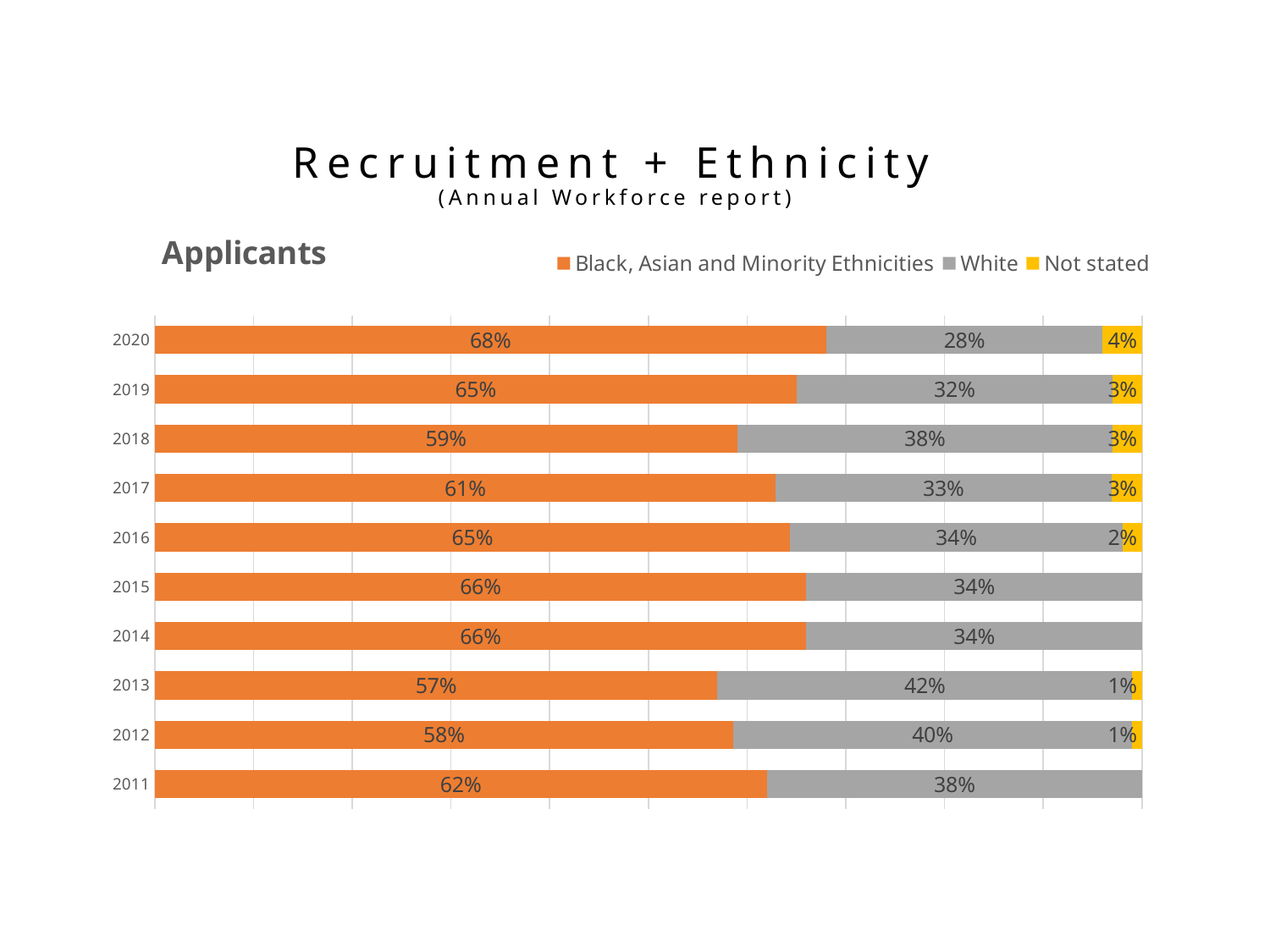
How many series does the legend list? 3 In which year was the Black, Asian and Minority Ethnicities share of applicants lowest? 2013 In which year was the Black, Asian and Minority Ethnicities share of applicants highest? 2020 What was the White share of applicants in 2013? 42% What percentage of applicants in 2016 had ethnicity 'Not stated'? 2% What percentage of applicants in 2020 were from Black, Asian and Minority Ethnicities? 68% What is the total of the three segments in the 2020 bar? 100% What kind of chart is shown on the slide? Stacked bar chart In which year was the White share of applicants highest? 2013 Which year had a larger Black, Asian and Minority Ethnicities share of applicants, 2017 or 2018? 2017 In 2020, how many percentage points higher is the Black, Asian and Minority Ethnicities share than the White share? 40 percentage points How many years are shown on the chart? 10